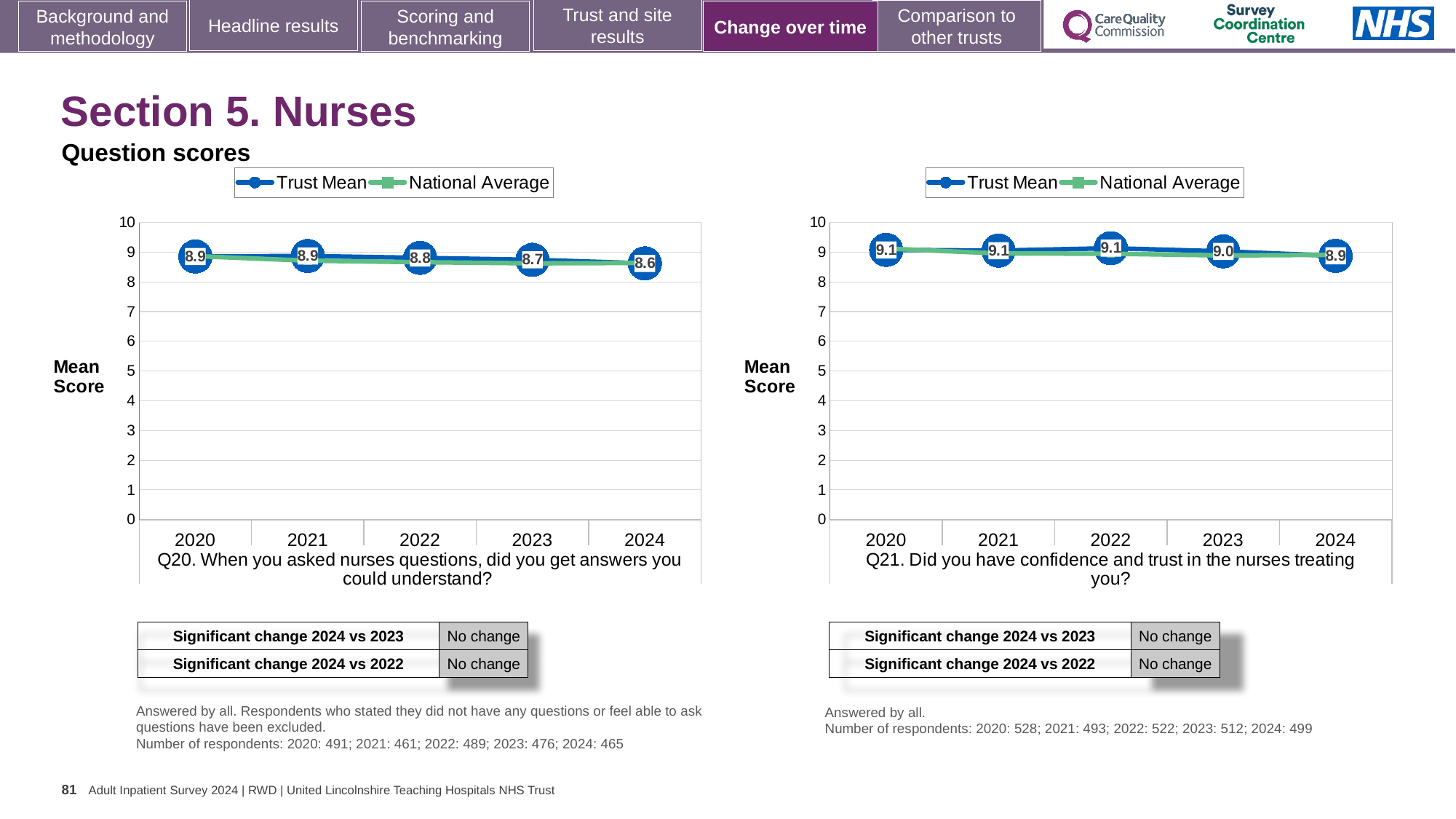
In the Q20 chart, what is the Trust Mean score for 2022? 8.8 In the Q21 chart, which year has the lowest Trust Mean score? 2024 In the Q20 chart, which year has the lowest Trust Mean score? 2024 In the Q21 chart, is the Trust Mean score higher in 2022 or in 2024? 2022 In the Q21 chart, what is the Trust Mean score for 2023? 9.0 In the Q20 chart, what is the Trust Mean score for 2024? 8.6 How many years are plotted on the x axis of the Q21 chart? 5 What kind of chart is used for Q21? Line chart In the Q20 chart, what is the difference between the Trust Mean score in 2020 and in 2024? 0.3 In the Q20 chart, is the National Average for 2024 greater or less than 8? greater How many series does the legend of the Q20 chart list? 2 In the Q21 chart, what is the Trust Mean score for 2020? 9.1